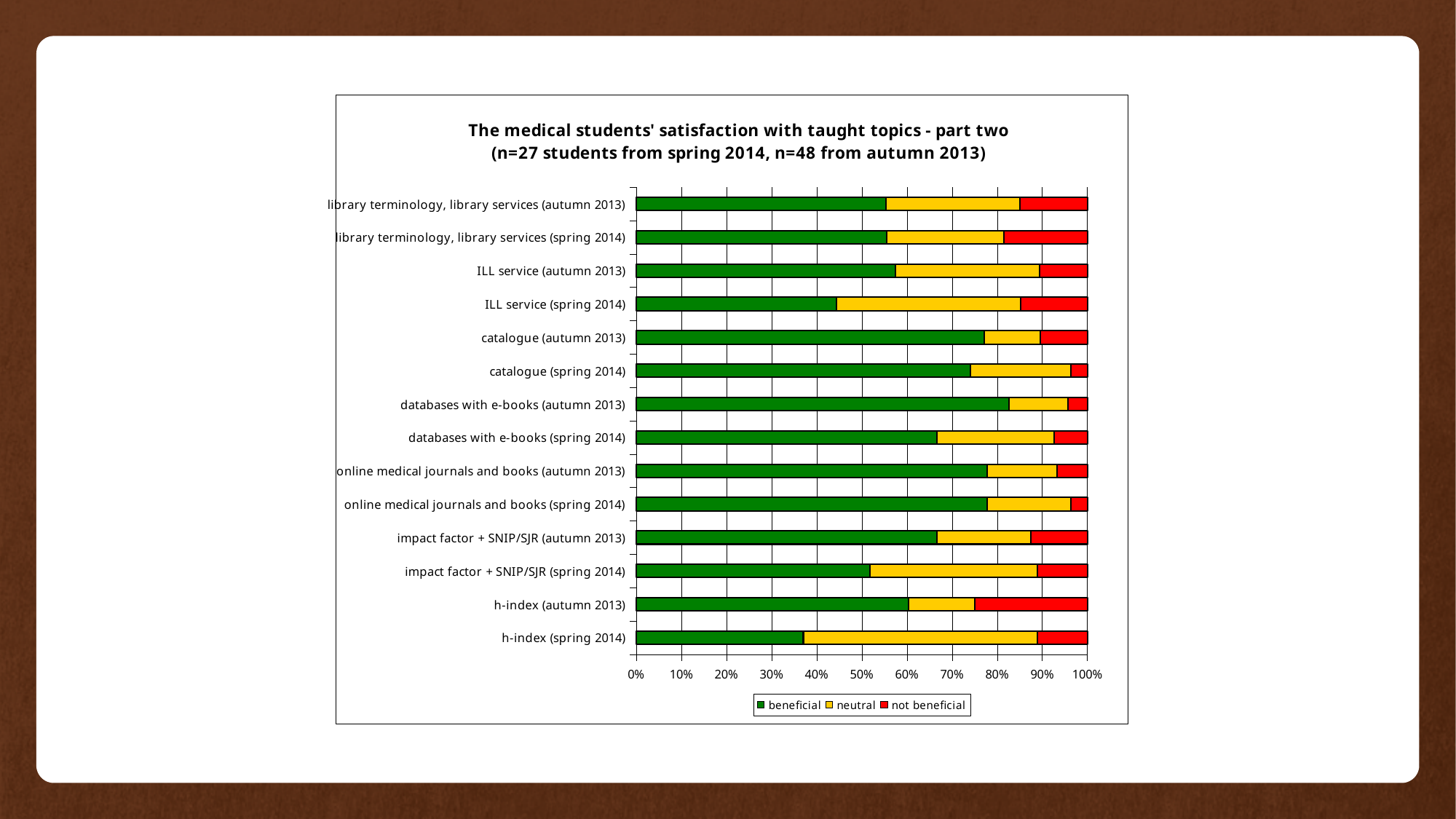
Is the 'beneficial' share for ILL service (spring 2014) greater or less than 50%? less Which category has the largest 'not beneficial' share? h-index (autumn 2013) What are the three series named in the legend? beneficial, neutral, not beneficial Is the 'beneficial' share for h-index (spring 2014) greater or less than 50%? less How many categories (bars) are plotted in the chart? 14 Which category has the smallest 'beneficial' share? h-index (spring 2014) Which category has the largest 'beneficial' share? databases with e-books (autumn 2013) How many series does the legend list? 3 What kind of chart is shown on the slide? bar chart What is the title of the chart? The medical students' satisfaction with taught topics - part two (n=27 students from spring 2014, n=48 from autumn 2013) Is the 'beneficial' share for databases with e-books (autumn 2013) greater or less than 80%? greater Which has the larger 'beneficial' share: catalogue (spring 2014) or ILL service (spring 2014)? catalogue (spring 2014)